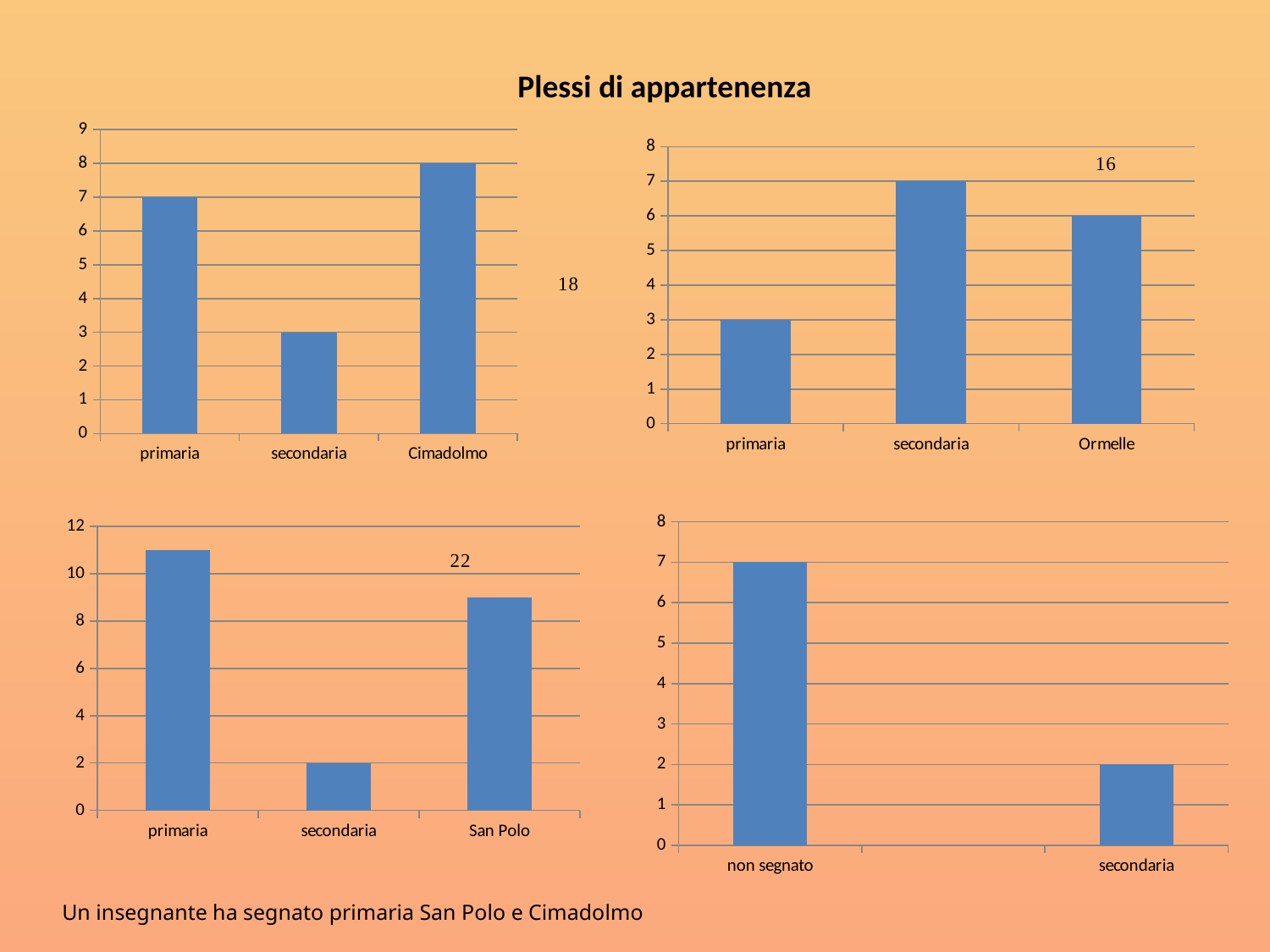
In the top-right chart, which category has the lowest value? primaria In the bottom-left chart, is the value for primaria greater or less than 10? greater In the top-right chart, which is larger, the value for secondaria or the value for Ormelle? secondaria In the top-left chart, which category has the highest value? Cimadolmo In the top-left chart, what is the value for secondaria? 3 In the top-left chart, what is the value for Cimadolmo? 8 How many categories does the bottom-right chart show? 2 In the top-right chart, what is the value for Ormelle? 6 What kind of chart is the top-right chart? bar chart In the bottom-left chart, what is the value for secondaria? 2 In the top-left chart, what is the difference between the values for primaria and secondaria? 4 In the bottom-right chart, what is the value for non segnato? 7